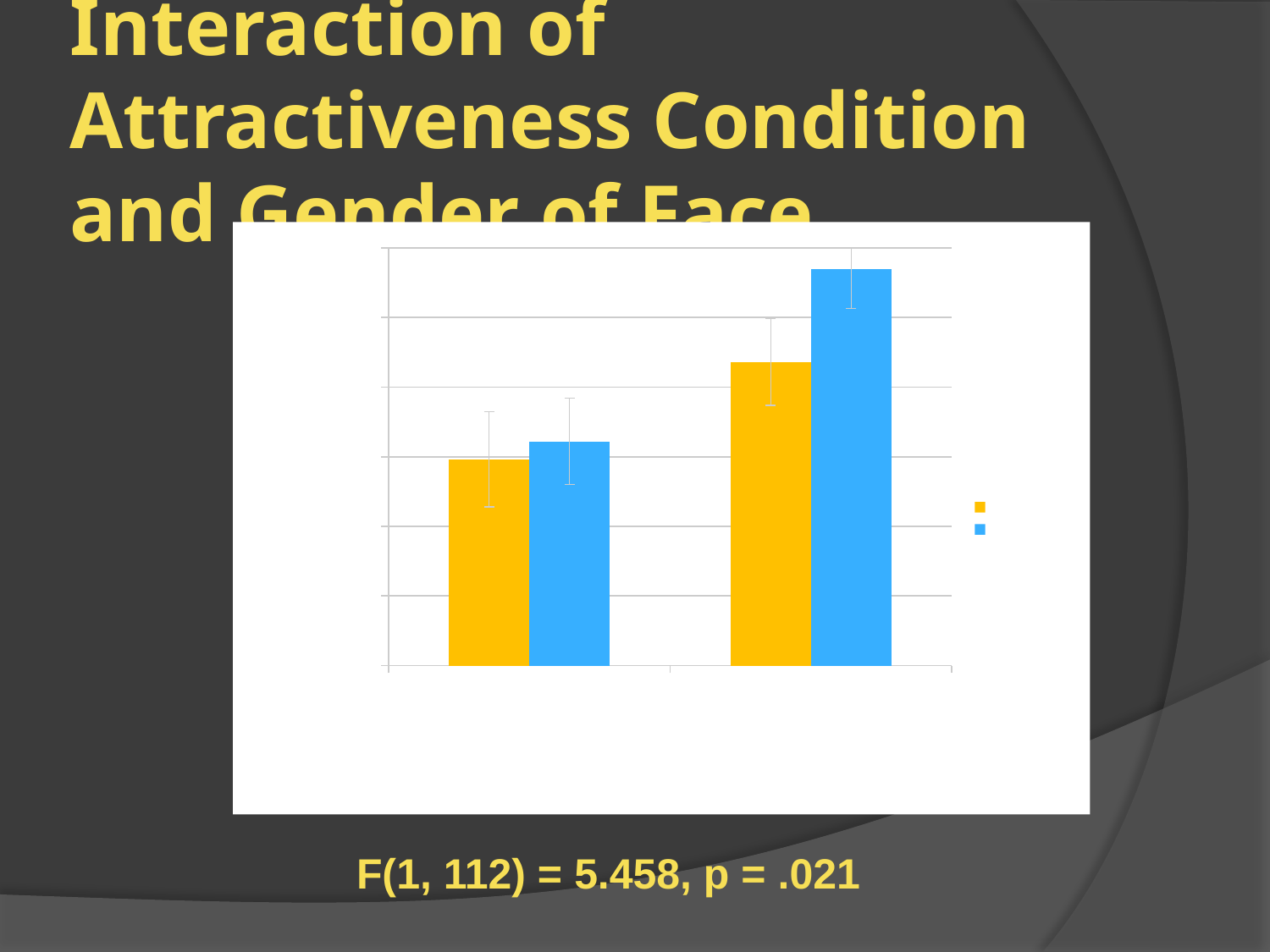
How many bars are plotted in total on the chart? 4 In the right group of bars, which is taller, the yellow bar or the blue bar? the blue bar Do the bar values rise or fall from the left group to the right group? rise How many groups of bars are plotted along the x axis? 2 What statistic is printed below the chart? F(1, 112) = 5.458, p = .021 Which group of bars has higher values, the left group or the right group? the right group What two colours are used for the bars in the chart? yellow and blue What kind of chart is shown on the slide? bar chart How many series does the chart's legend list? 2 In the left group of bars, which is taller, the yellow bar or the blue bar? the blue bar Which bar is the tallest on the chart? the blue bar in the right group Which bar is the shortest on the chart? the yellow bar in the left group